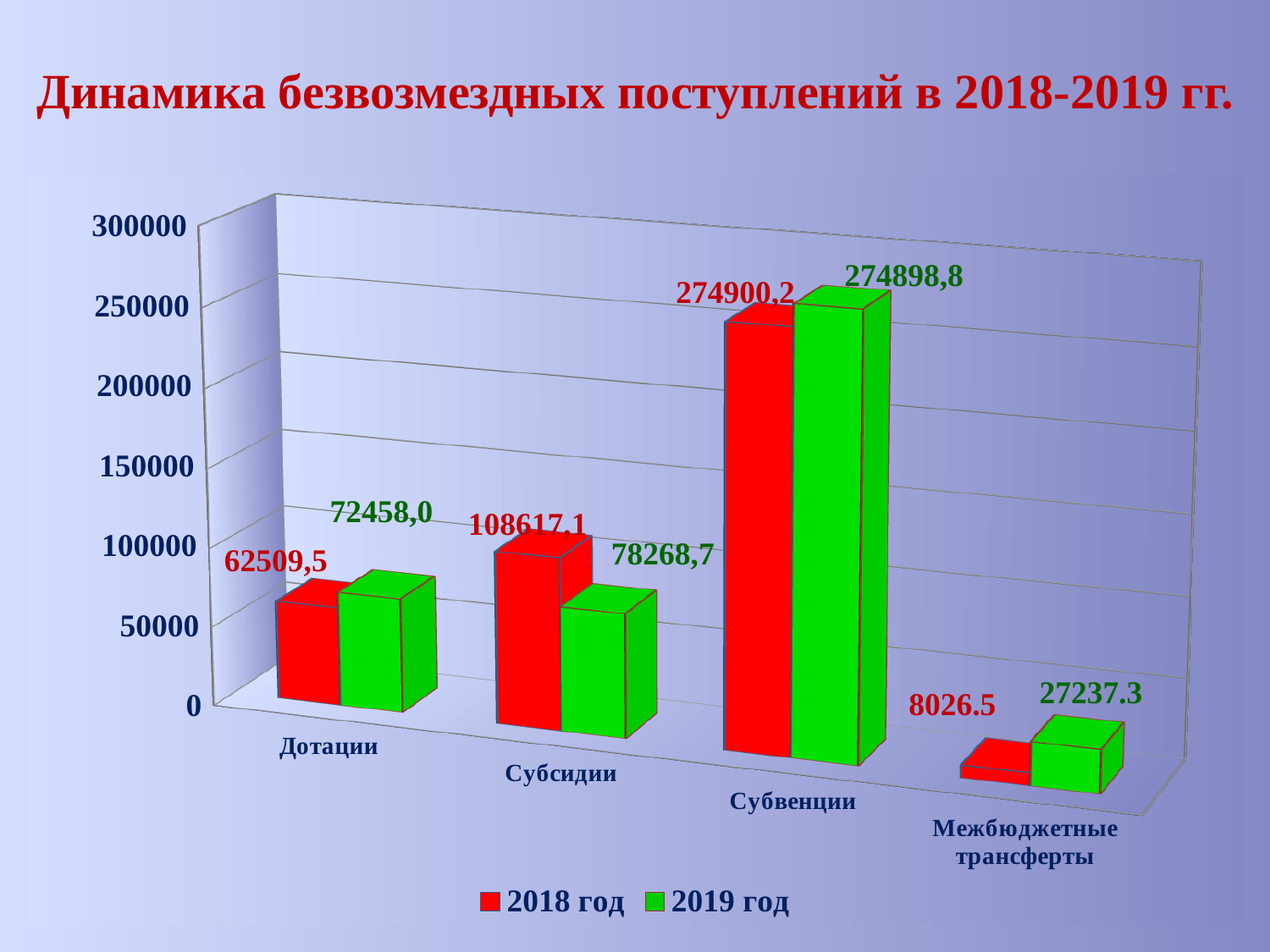
Which category has the lowest value in the 2019 год series? Межбюджетные трансферты What is the value for Межбюджетные трансферты in the 2018 год series? 8026.5 What is the value for Субвенции in the 2019 год series? 274898,8 What is the value for Субсидии in the 2019 год series? 78268,7 For Субсидии, which series has the larger value, 2018 год or 2019 год? 2018 год How many categories are shown on the x axis? 4 What is the difference between the 2018 год and 2019 год values for Субсидии? 30348,4 How many series does the legend list? 2 What is the difference between the 2019 год and 2018 год values for Дотации? 9948,5 What is the value for Дотации in the 2018 год series? 62509,5 Which category has the highest value in the 2018 год series? Субвенции Is the 2019 год value for Субсидии greater or less than 100000? less